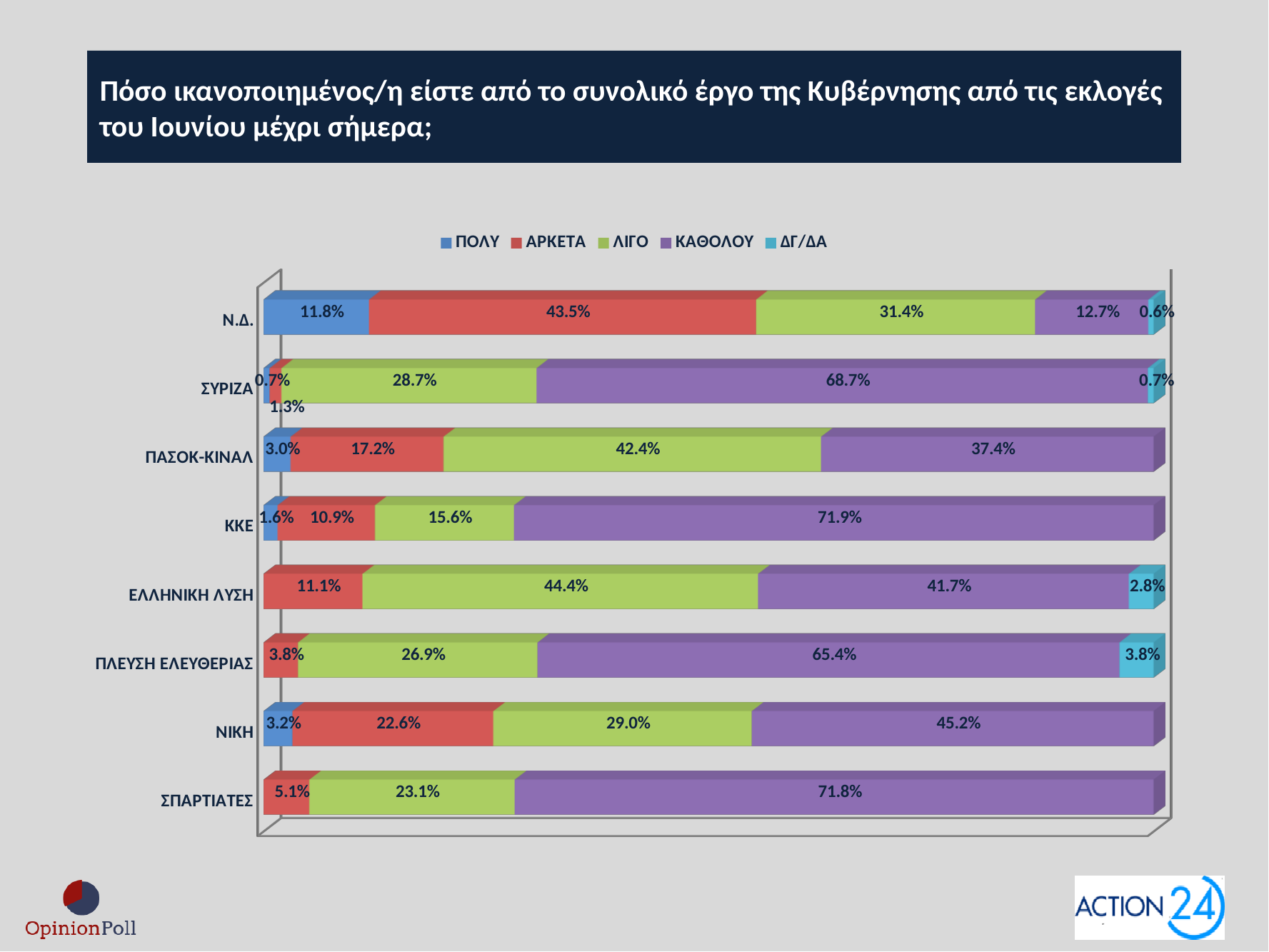
What percentage of Ν.Δ. respondents answered ΑΡΚΕΤΑ? 43.5% What is the ΛΙΓΟ value for ΠΑΣΟΚ-ΚΙΝΑΛ? 42.4% Which party has the lowest ΚΑΘΟΛΟΥ value? Ν.Δ. Which is larger: the ΚΑΘΟΛΟΥ value for ΣΥΡΙΖΑ or for ΠΛΕΥΣΗ ΕΛΕΥΘΕΡΙΑΣ? ΣΥΡΙΖΑ What kind of chart is shown on the slide? Stacked bar chart What is the ΚΑΘΟΛΟΥ value for ΚΚΕ? 71.9% What is the ΔΓ/ΔΑ value for ΠΛΕΥΣΗ ΕΛΕΥΘΕΡΙΑΣ? 3.8% How many parties are shown on the chart? 8 Which party has the highest ΑΡΚΕΤΑ value? Ν.Δ. What is the total of the ΣΠΑΡΤΙΑΤΕΣ bar? 100.0% What is the difference between the ΑΡΚΕΤΑ and ΛΙΓΟ values for Ν.Δ.? 12.1 percentage points How many series does the legend list? 5